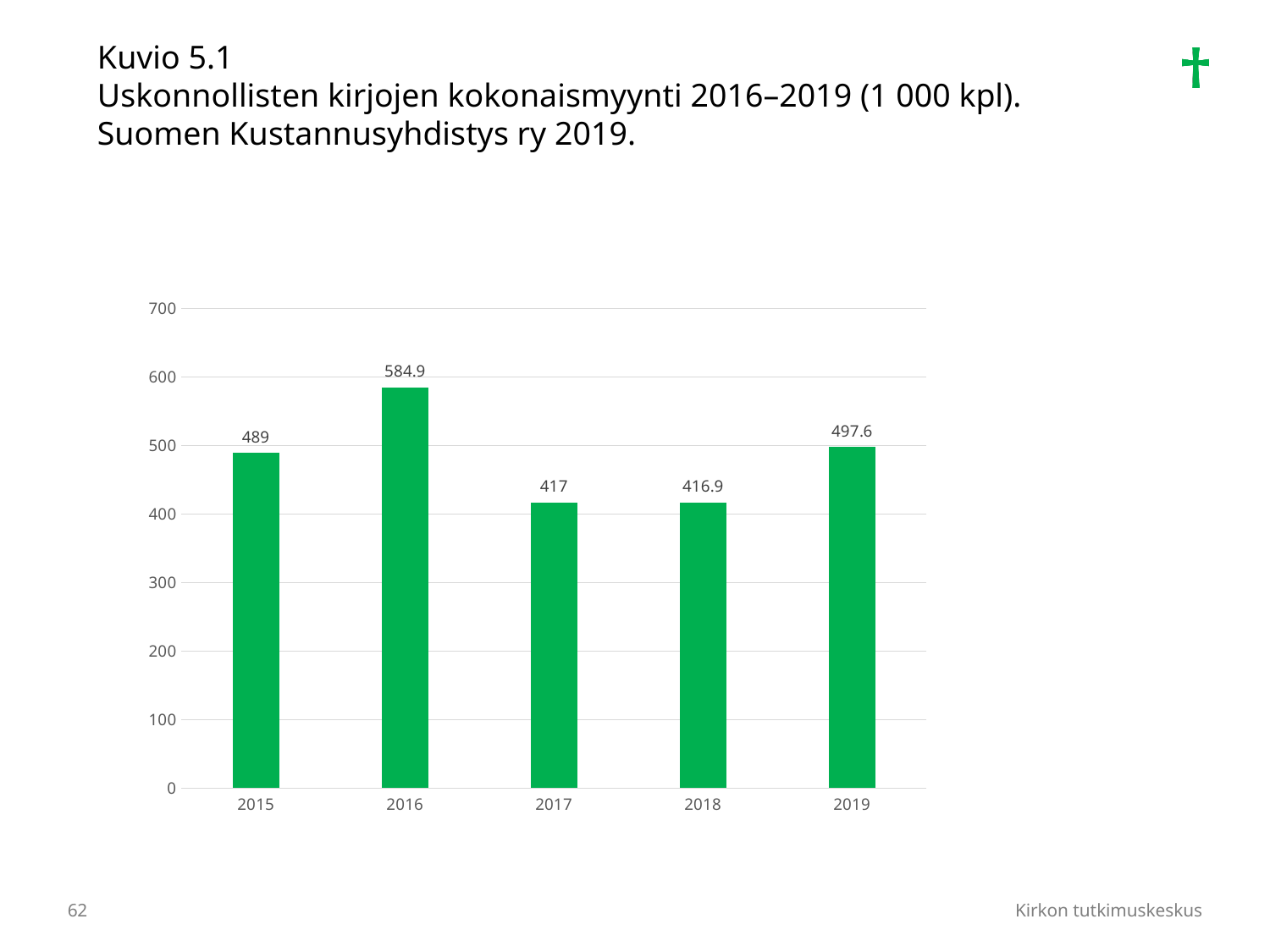
How many years are shown on the x axis? 5 Is the value for 2017 greater or less than 500? less Do the values rise or fall from 2016 to 2017? fall What is the difference between the values for 2019 and 2018? 80.7 What kind of chart is shown on the slide? bar chart What is the value for 2016? 584.9 Which year has the highest value? 2016 What is the value for 2019? 497.6 What is the difference between the values for 2016 and 2015? 95.9 What is the value for 2015? 489 What colour are the bars in the chart? green Which is larger, the value for 2015 or the value for 2019? 2019